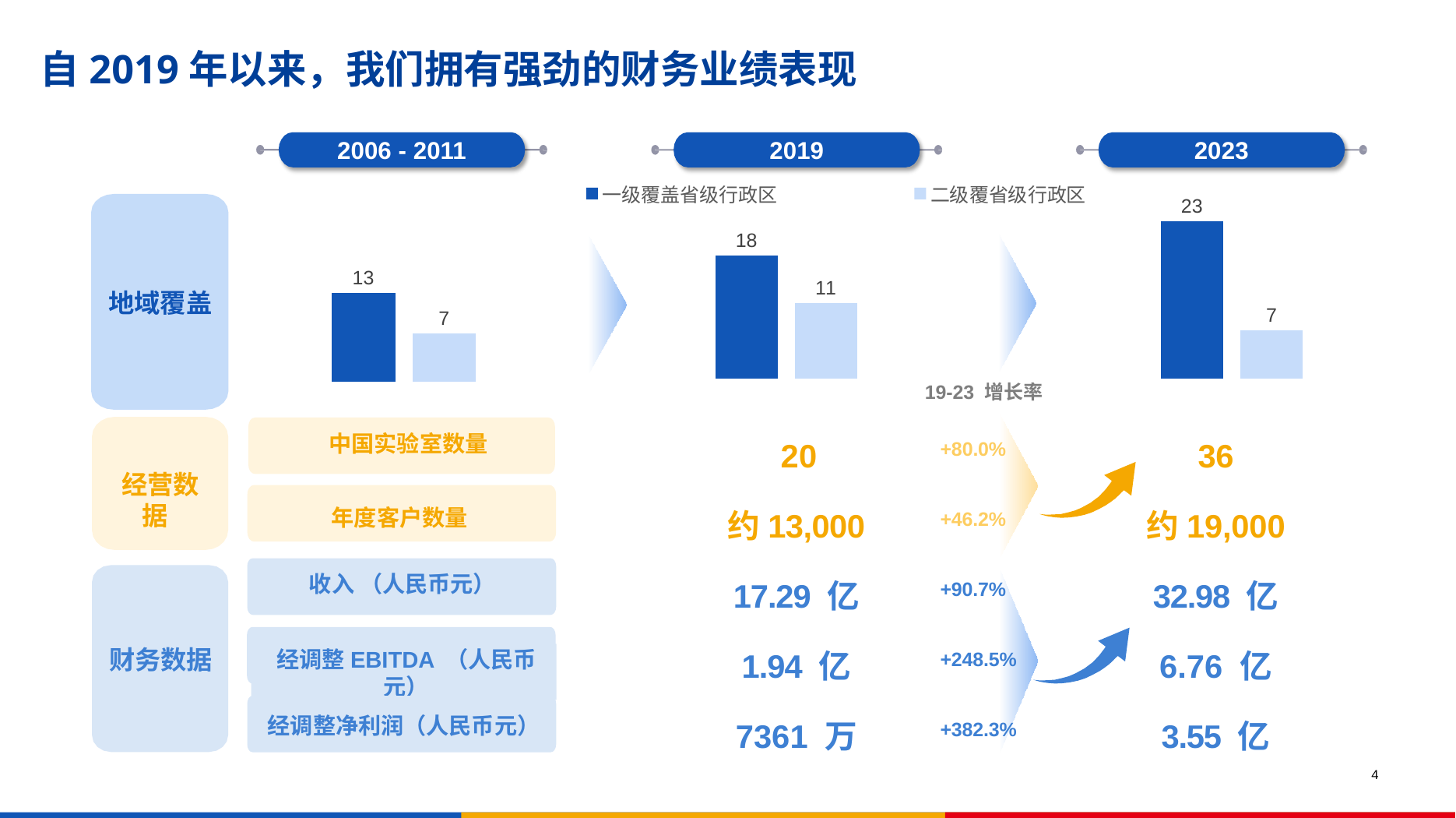
In the 地域覆盖 bar chart, what is the difference between the 一级覆盖省级行政区 values for 2019 and 2006 - 2011? 5 In the 地域覆盖 bar chart, what is the difference between 一级覆盖省级行政区 and 二级覆省级行政区 in 2023? 16 In the 地域覆盖 bar chart, what is the value of 一级覆盖省级行政区 for 2006 - 2011? 13 In the 地域覆盖 bar chart, what is the value of 二级覆省级行政区 for 2023? 7 In the 地域覆盖 bar chart, which period has the highest value for 二级覆省级行政区? 2019 In the 地域覆盖 bar chart, does the value of 一级覆盖省级行政区 rise or fall from 2006 - 2011 to 2023? rise In the 地域覆盖 bar chart, what is the value of 二级覆省级行政区 for 2019? 11 In the 地域覆盖 bar chart, what is the value of 一级覆盖省级行政区 for 2019? 18 In the 地域覆盖 bar chart, which period has the highest value for 一级覆盖省级行政区? 2023 What kind of chart is used for 地域覆盖 on the slide? bar chart In the 地域覆盖 bar chart, which is larger in 2019: 一级覆盖省级行政区 or 二级覆省级行政区? 一级覆盖省级行政区 How many series does the legend of the 地域覆盖 bar chart list? 2